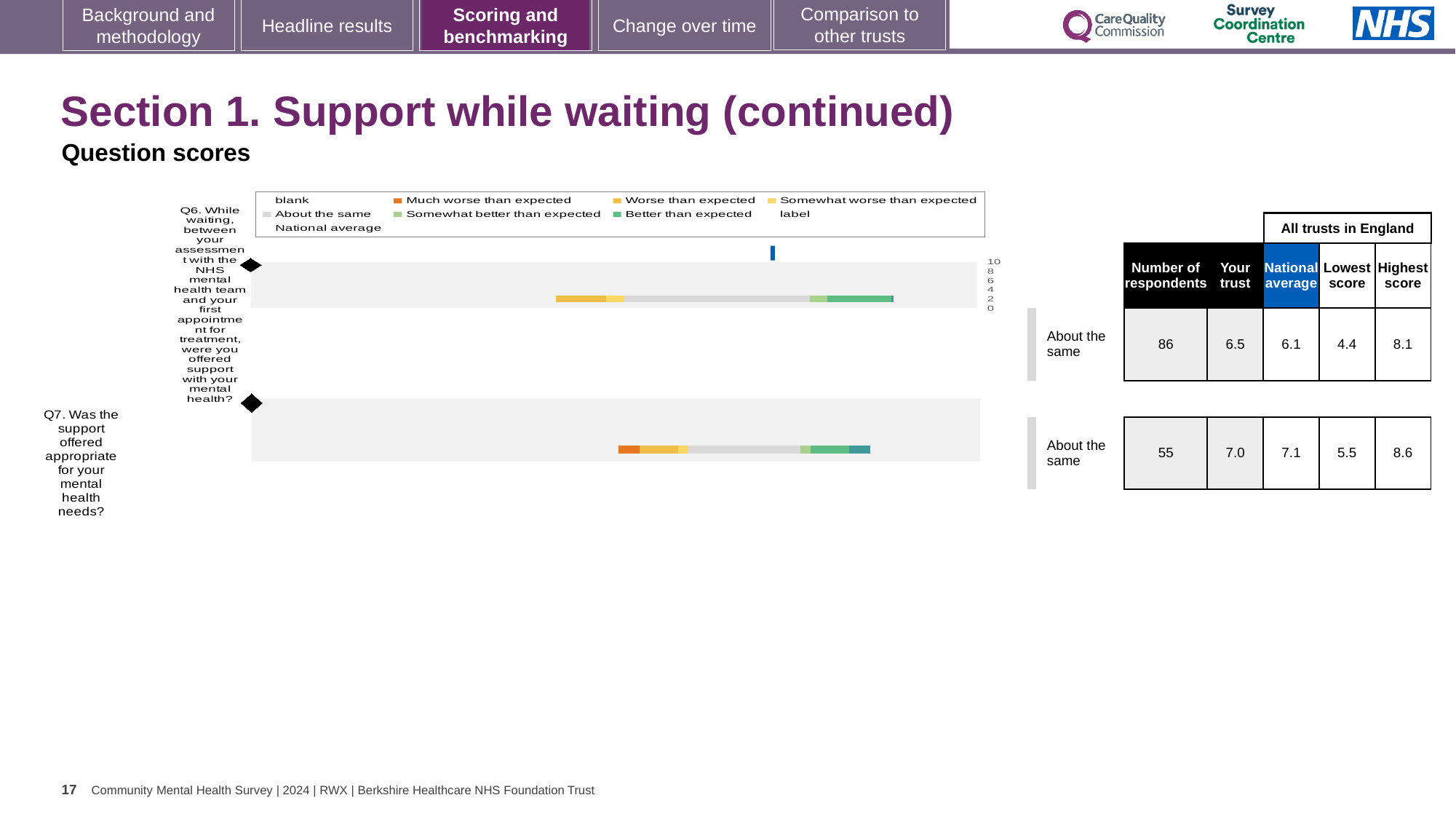
How many questions (bars) are plotted in the chart? 2 What benchmark category is Q6 rated as? About the same Which question has the higher 'Your trust' score, Q6 or Q7? Q7 What is the difference in the number of respondents between Q6 and Q7? 31 What is the national average score for Q6? 6.1 What kind of chart is shown on the slide? bar chart What is the 'Your trust' score for Q7? 7.0 What is the number of respondents for Q7? 55 What is the 'Your trust' score for Q6? 6.5 What is the difference between the 'Your trust' scores for Q7 and Q6? 0.5 What is the highest score among all trusts in England for Q7? 8.6 What is the lowest score among all trusts in England for Q6? 4.4